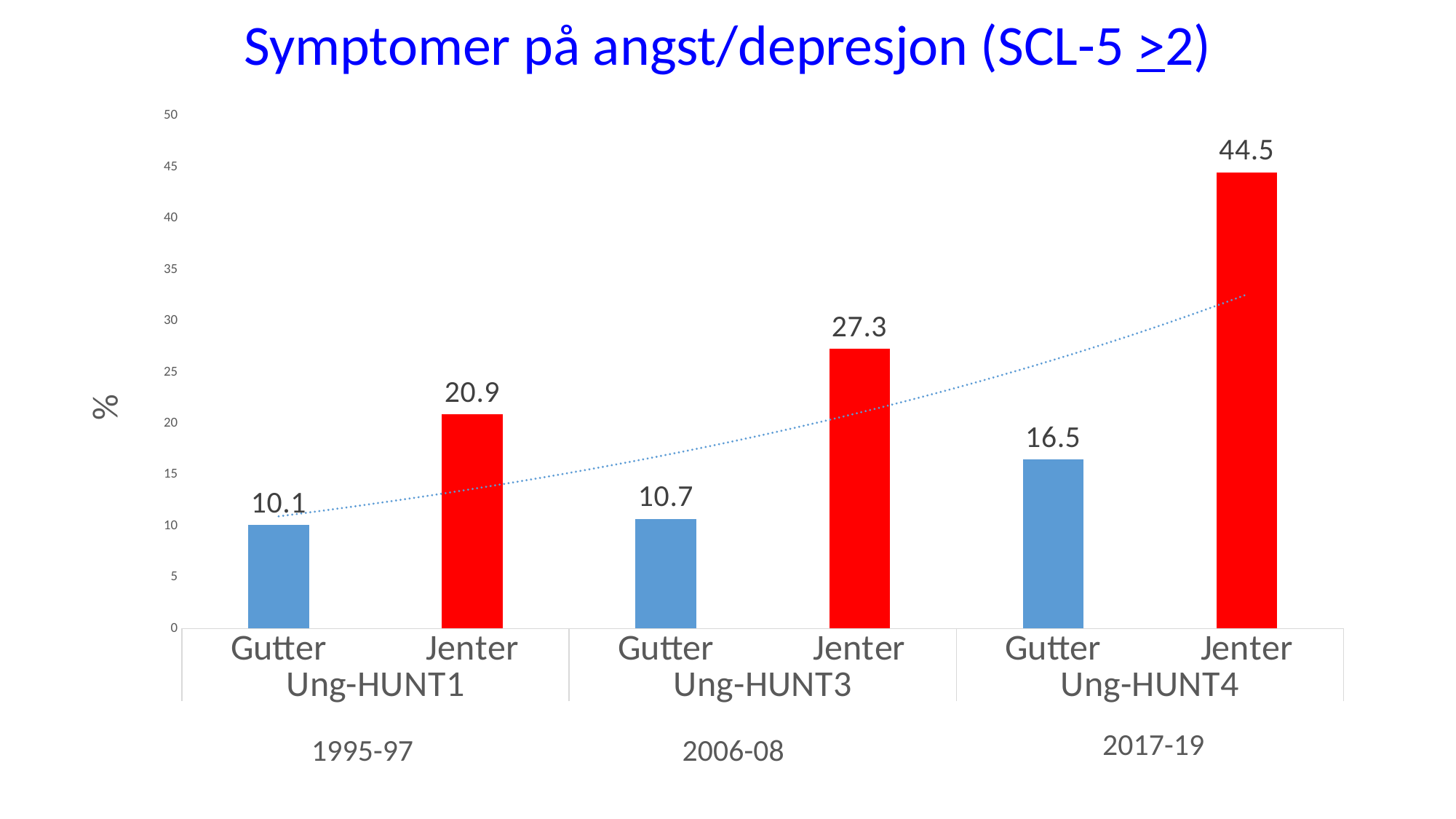
What kind of chart is shown on the slide? Bar chart What is the value for Jenter in Ung-HUNT4? 44.5 What is the value for Jenter in Ung-HUNT3? 27.3 Do the Jenter values rise or fall from Ung-HUNT1 to Ung-HUNT4? Rise What is the difference between Jenter in Ung-HUNT4 and Jenter in Ung-HUNT1? 23.6 Which is larger, Gutter in Ung-HUNT3 or Gutter in Ung-HUNT4? Gutter in Ung-HUNT4 How many bars are plotted in the chart? 6 Which bar has the highest value? Jenter, Ung-HUNT4 Which bar has the lowest value? Gutter, Ung-HUNT1 What is the difference between Jenter and Gutter in Ung-HUNT4? 28 What is the value for Gutter in Ung-HUNT4? 16.5 What is the value for Gutter in Ung-HUNT1? 10.1